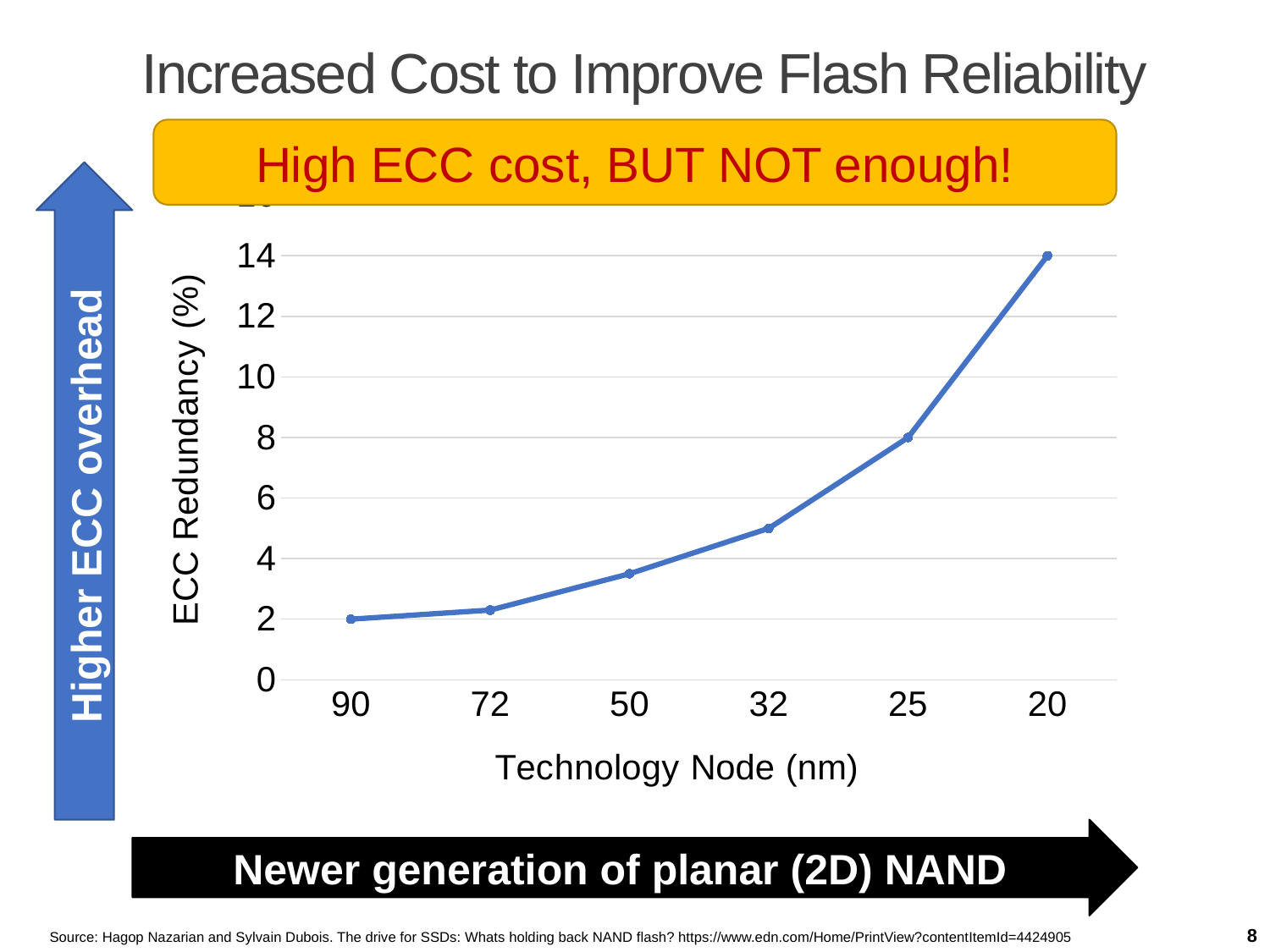
Is the ECC redundancy at the 32 nm node greater or less than 4? greater Which technology node has the highest ECC redundancy? 20 What is the difference in ECC redundancy (%) between the 20 nm and 25 nm nodes? 6 What kind of chart is shown on the slide? line chart What is the ECC redundancy (%) at the 20 nm technology node? 14 What is the difference in ECC redundancy (%) between the 20 nm and 90 nm nodes? 12 What is the ECC redundancy (%) at the 25 nm technology node? 8 Which technology node has the lowest ECC redundancy? 90 Does ECC redundancy rise or fall moving left to right along the x axis from 90 nm to 20 nm? rise What is the ECC redundancy (%) at the 90 nm technology node? 2 How many technology nodes are plotted on the x axis? 6 Which has a higher ECC redundancy, the 25 nm node or the 50 nm node? 25